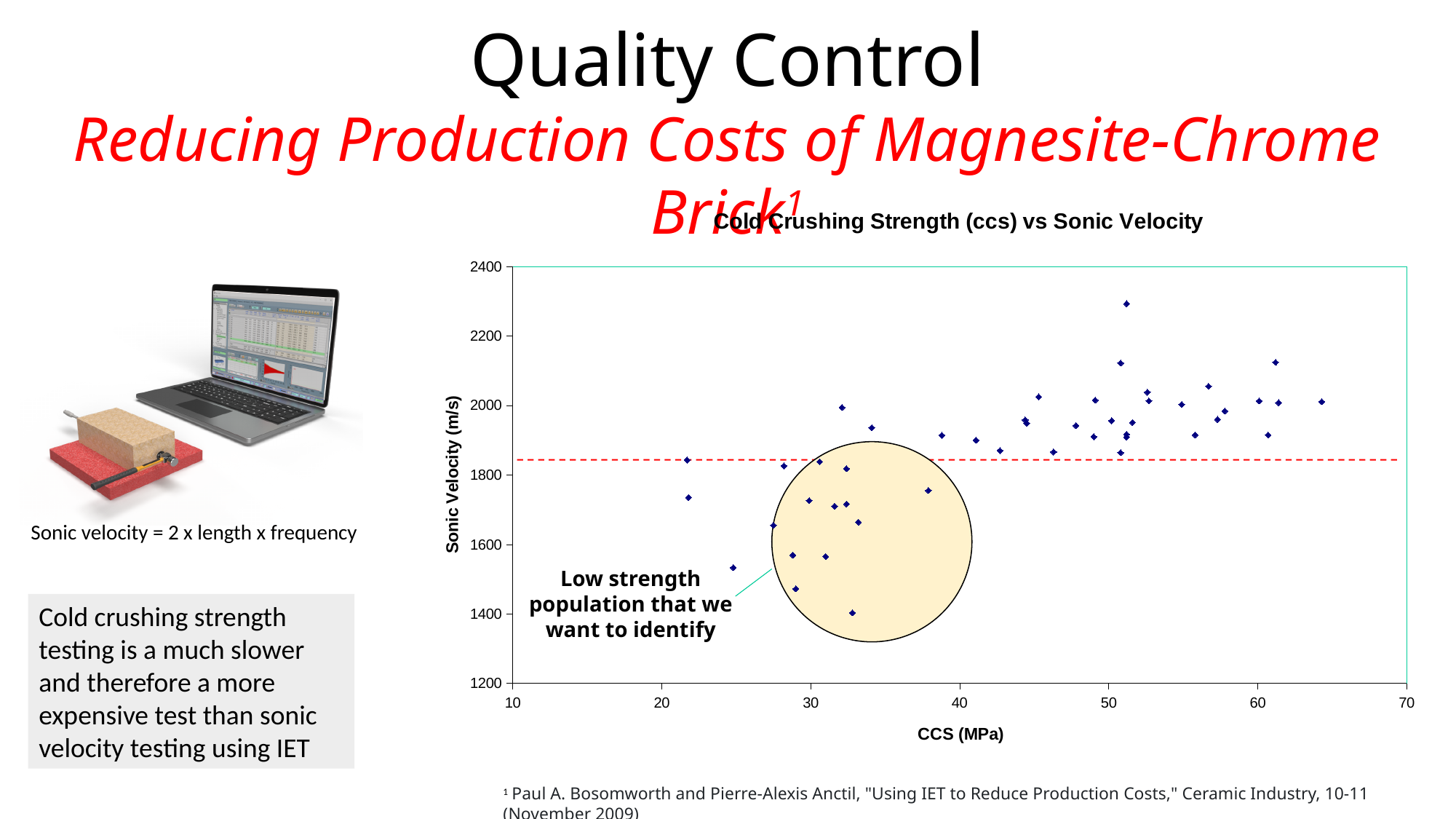
Are the points inside the circled 'low strength population' mostly above or below 1800 m/s? below What is the minimum value shown on the x axis of the chart? 10 Is the highest sonic velocity value plotted on the chart greater or less than 2200 m/s? greater Is the dashed red horizontal line on the chart above or below 1800 m/s? above What kind of chart is shown on the slide? scatter chart What is the label of the x axis of the chart? CCS (MPa) What is the maximum value shown on the y axis of the chart? 2400 Does sonic velocity generally rise or fall as CCS increases along the x axis? rise